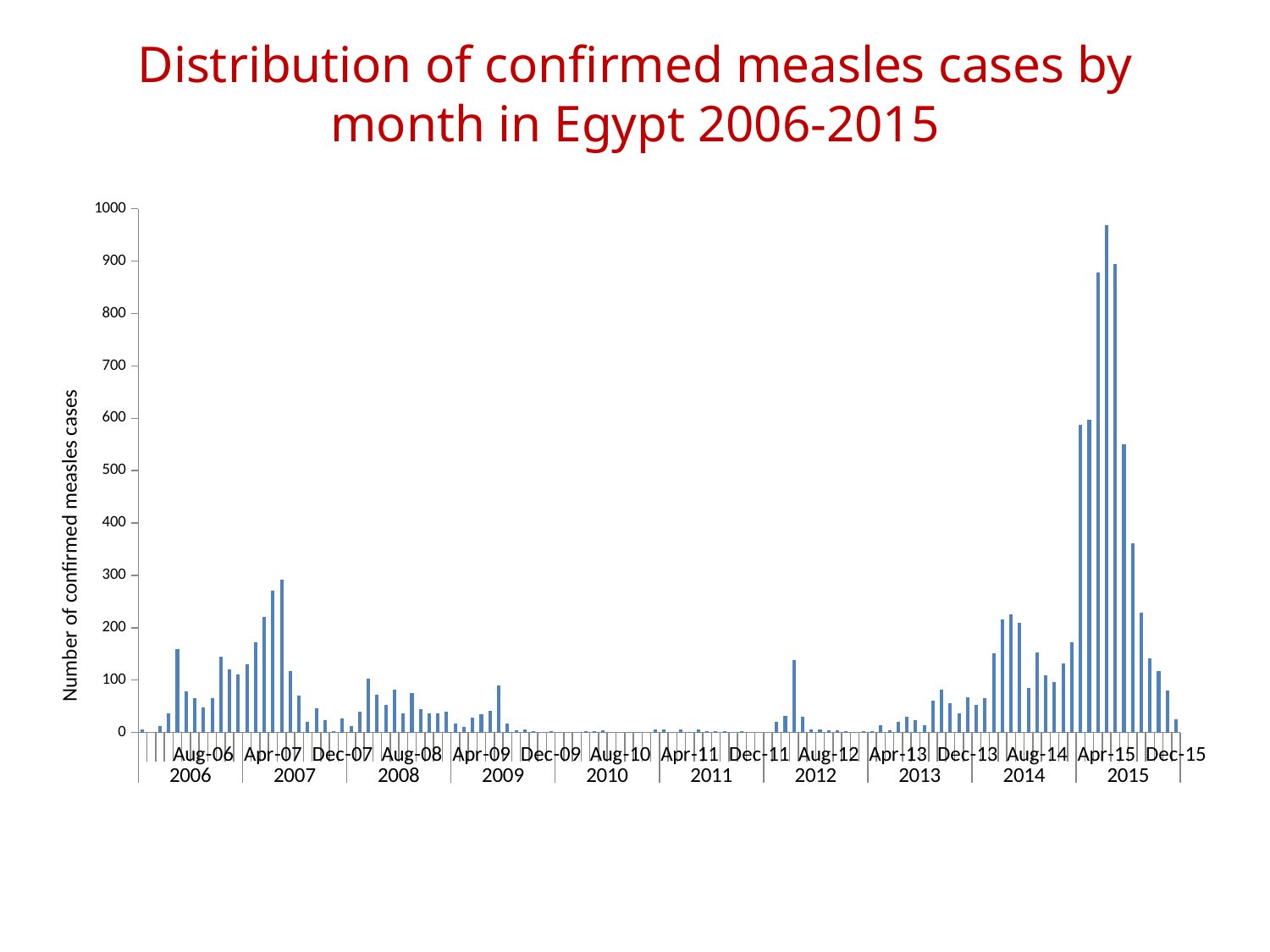
Is the highest monthly value in 2007 greater or less than 200? greater Which year has the higher peak monthly value, 2007 or 2008? 2007 In which year does the chart show the highest monthly number of confirmed measles cases? 2015 What is the highest value shown on the vertical axis of the chart? 1000 How many years are labelled along the x axis of the chart? 10 What is the label on the vertical axis of the chart? Number of confirmed measles cases What is the title of the chart? Distribution of confirmed measles cases by month in Egypt 2006-2015 Is the highest monthly value in 2015 greater or less than 900? greater Is the highest monthly value in 2010 greater or less than 100? less What kind of chart is shown on the slide? bar chart Which year has the higher peak monthly value, 2006 or 2014? 2014